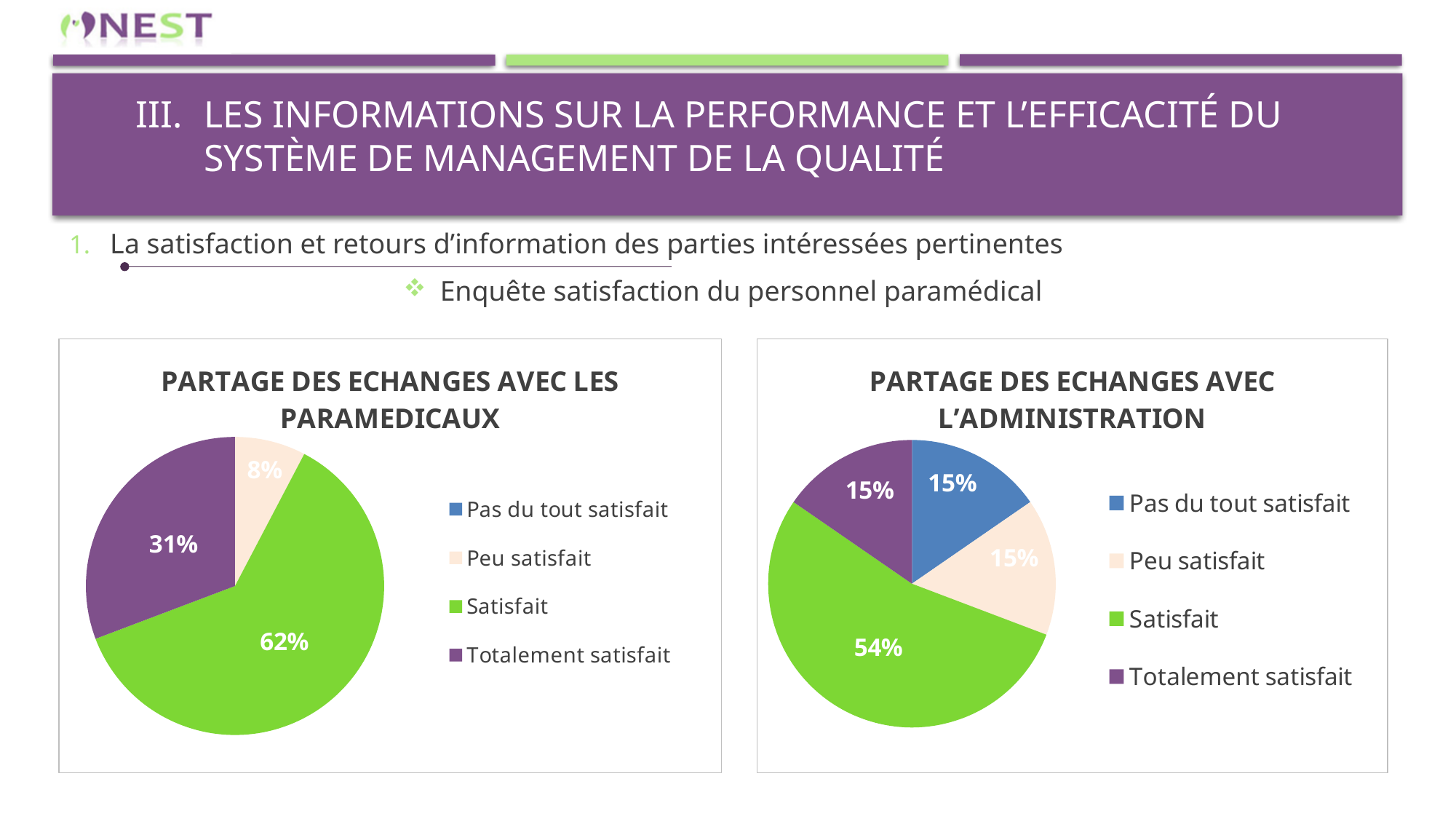
In the chart titled 'PARTAGE DES ECHANGES AVEC L'ADMINISTRATION', what share is labelled for 'Pas du tout satisfait'? 15% In the chart titled 'PARTAGE DES ECHANGES AVEC LES PARAMEDICAUX', which category has the largest slice? Satisfait What type of chart is the chart titled 'PARTAGE DES ECHANGES AVEC L'ADMINISTRATION'? Pie chart In the chart titled 'PARTAGE DES ECHANGES AVEC L'ADMINISTRATION', which category has the largest slice? Satisfait How many entries does the legend of the chart titled 'PARTAGE DES ECHANGES AVEC LES PARAMEDICAUX' list? 4 In the chart titled 'PARTAGE DES ECHANGES AVEC L'ADMINISTRATION', what share is labelled for 'Satisfait'? 54% In the chart titled 'PARTAGE DES ECHANGES AVEC LES PARAMEDICAUX', what share is labelled for 'Totalement satisfait'? 31% In the chart titled 'PARTAGE DES ECHANGES AVEC LES PARAMEDICAUX', what share is labelled for 'Satisfait'? 62% In the chart titled 'PARTAGE DES ECHANGES AVEC LES PARAMEDICAUX', what share is labelled for 'Peu satisfait'? 8% Which chart shows a larger share for 'Satisfait': the left chart (PARAMEDICAUX) or the right chart (L'ADMINISTRATION)? The left chart (PARAMEDICAUX) In the chart titled 'PARTAGE DES ECHANGES AVEC L'ADMINISTRATION', what is the difference between the 'Satisfait' share and the 'Peu satisfait' share? 39% In the chart titled 'PARTAGE DES ECHANGES AVEC LES PARAMEDICAUX', what is the difference between the 'Satisfait' and 'Totalement satisfait' shares? 31%